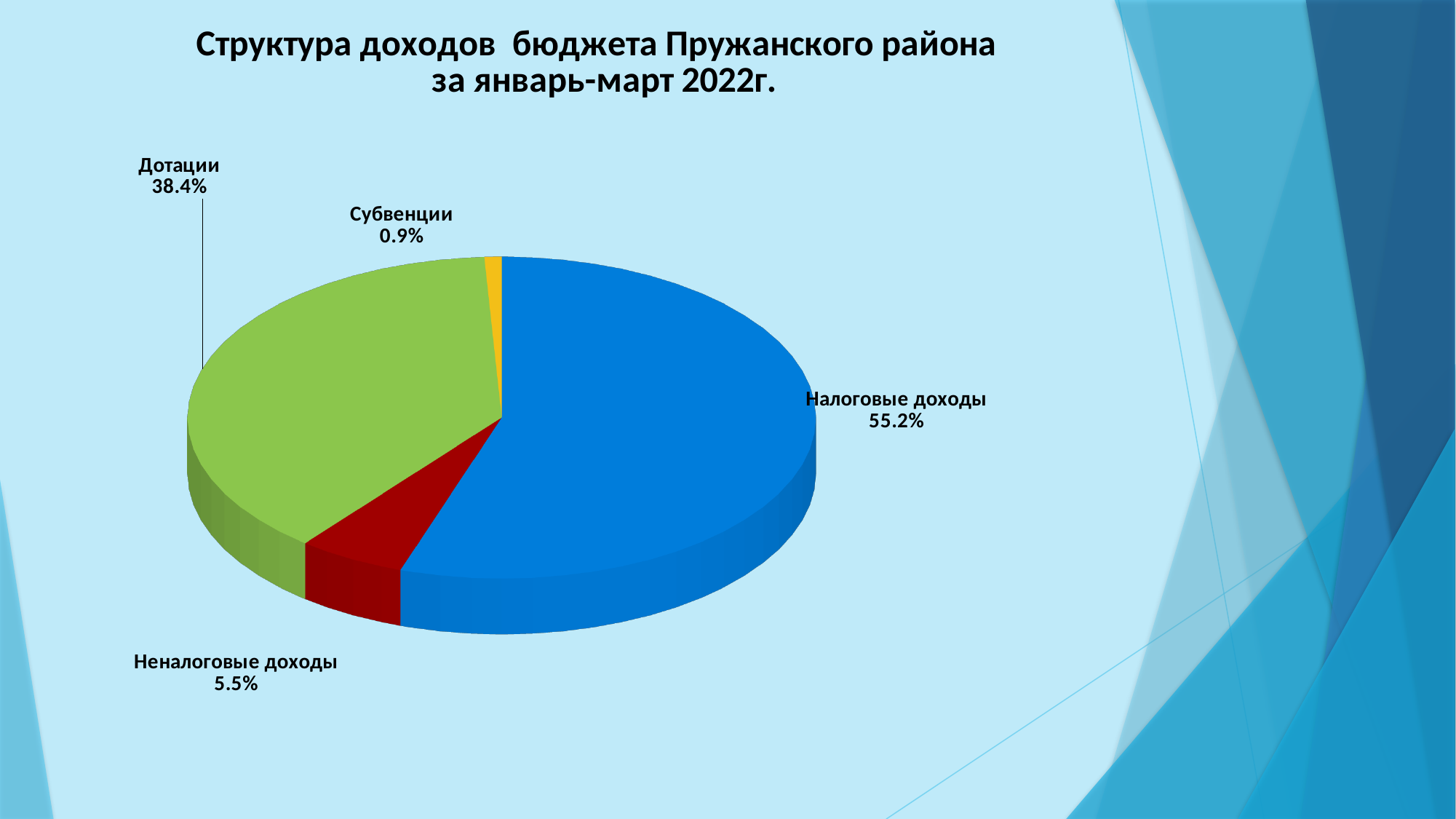
What is the value shown for Субвенции? 0.9% Which is larger, the share of Дотации or the share of Неналоговые доходы? Дотации What colour is the slice for Неналоговые доходы? Dark red What is the difference between the shares of Налоговые доходы and Дотации? 16.8% Which category has the smallest slice of the pie? Субвенции Which category has the largest slice of the pie? Налоговые доходы What is the difference between the shares of Неналоговые доходы and Субвенции? 4.6% What share of the pie does Налоговые доходы have? 55.2% What is the value shown for Неналоговые доходы? 5.5% How many categories are shown in the pie chart? 4 What is the value shown for Дотации? 38.4% What kind of chart is shown on the slide? Pie chart